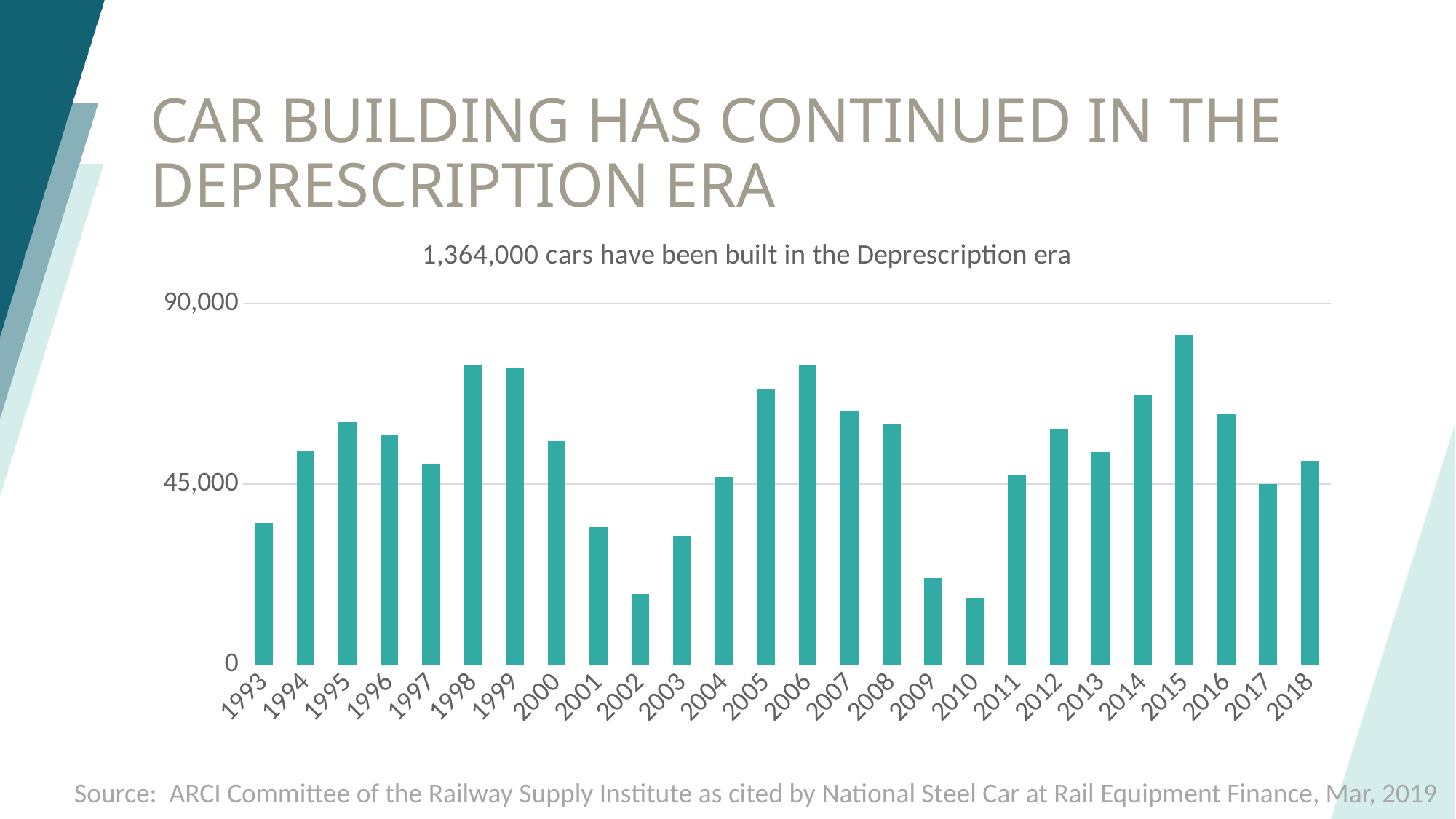
What is the title of the chart? 1,364,000 cars have been built in the Deprescription era Is the value for 2002 greater or less than 45,000? less Which year has the larger value, 2001 or 1999? 1999 Which year has the larger value, 2006 or 2010? 2006 Is the value for 1998 greater or less than 45,000? greater Is the value for 2009 greater or less than 45,000? less Do the values rise or fall from 2006 to 2010? fall What kind of chart is shown on the slide? bar chart Which year has the highest bar in the chart? 2015 How many years are shown on the x axis of the chart? 26